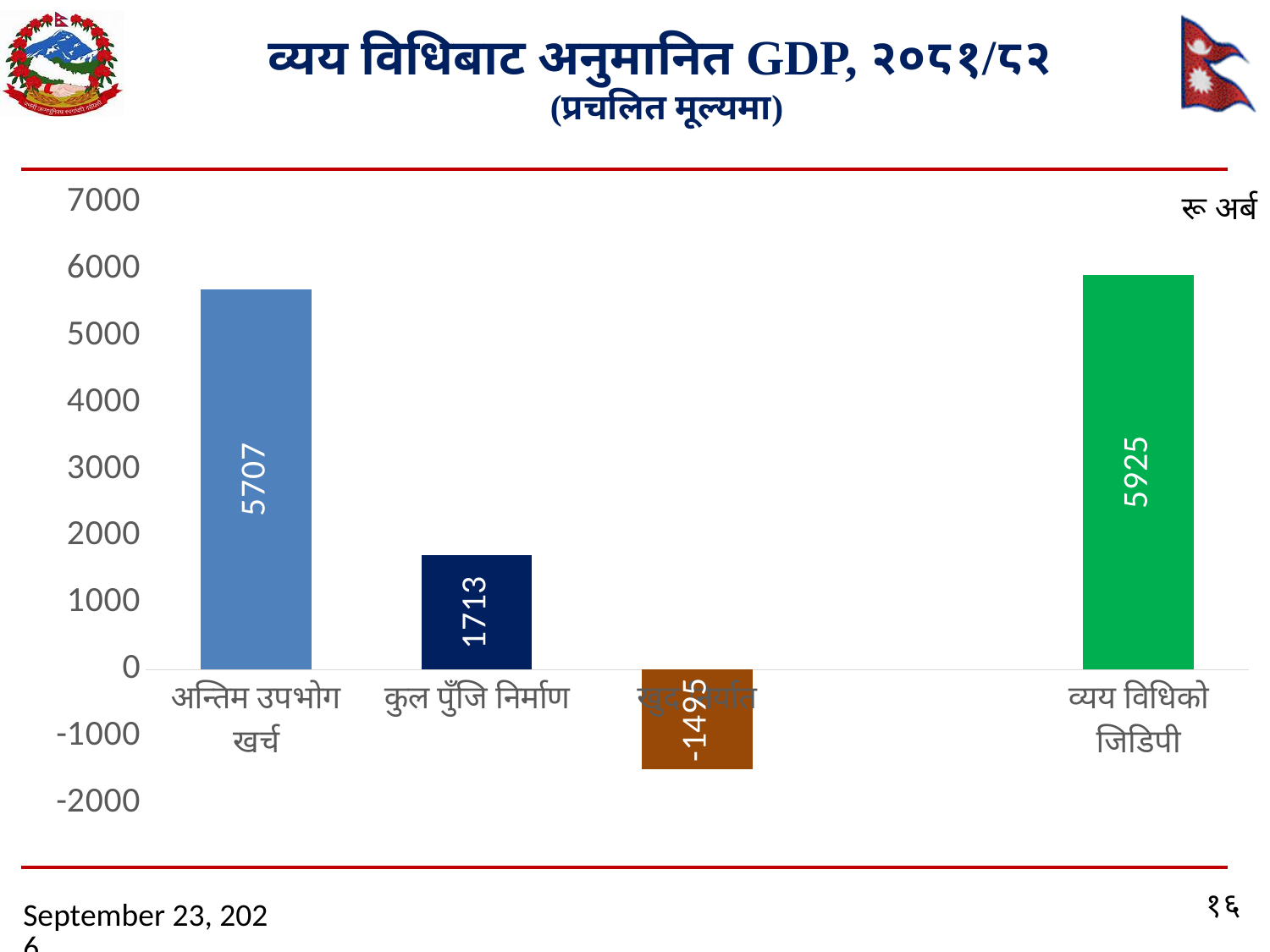
What is the value of the third bar (खुद निर्यात), the one that goes below zero? -1495 What is the difference between the values for व्यय विधिको जिडिपी and अन्तिम उपभोग खर्च? 218 What is the value of the bar for अन्तिम उपभोग खर्च? 5707 Which is larger, the value for अन्तिम उपभोग खर्च or the value for व्यय विधिको जिडिपी? व्यय विधिको जिडिपी What unit is indicated at the top right of the chart? रू अर्ब Which category has the lowest value in the chart? खुद निर्यात What is the difference between the values for अन्तिम उपभोग खर्च and कुल पुँजि निर्माण? 3994 Which category has the highest value in the chart? व्यय विधिको जिडिपी What is the value of the bar for कुल पुँजि निर्माण? 1713 What is the value of the bar for व्यय विधिको जिडिपी? 5925 How many bars are plotted in the chart? 4 What kind of chart is shown on the slide? Bar chart